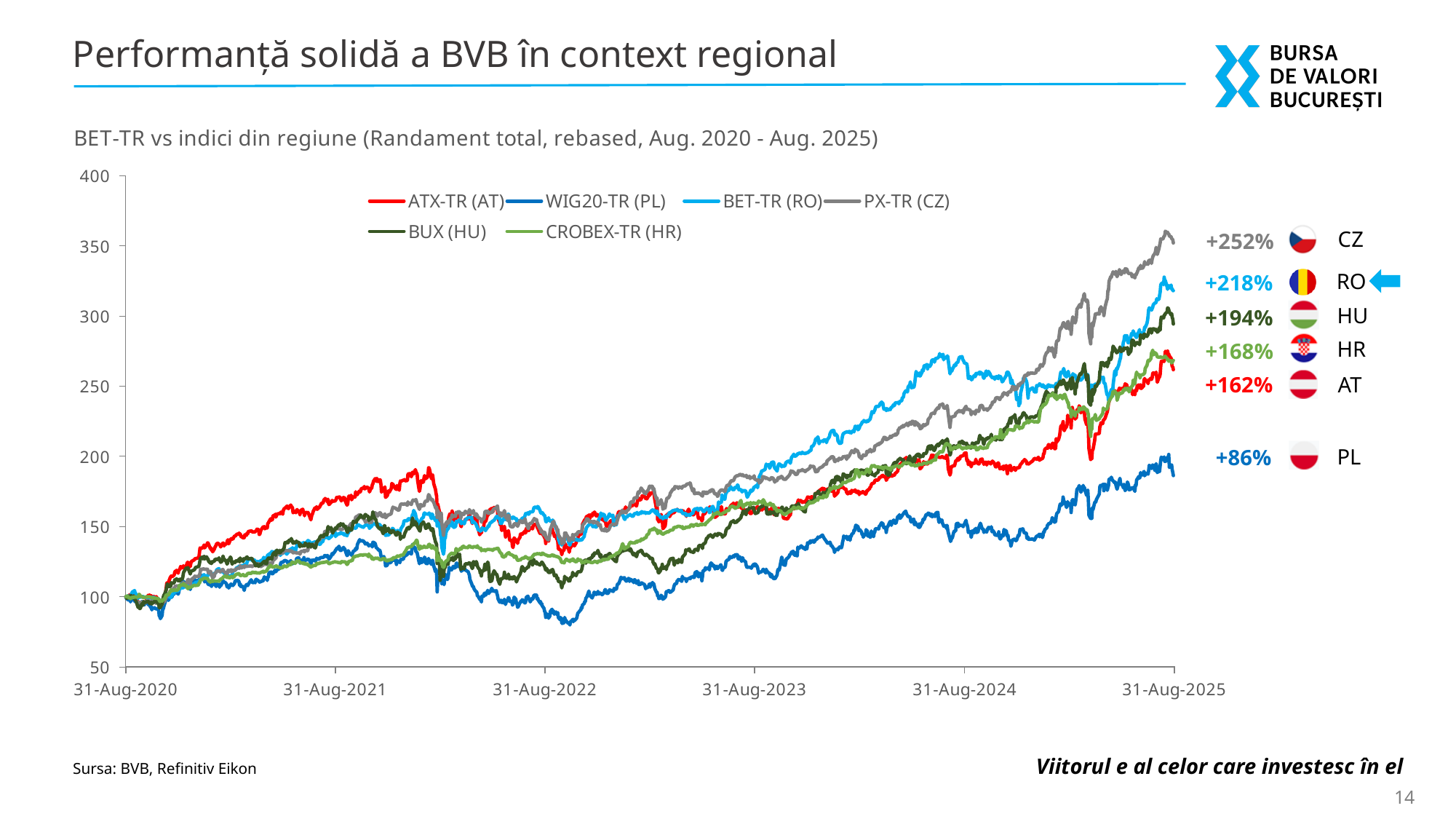
By how many percentage points does the CZ return exceed the RO return? 34 percentage points What total return is shown for PL (WIG20-TR) over the period? +86% What total return is shown for CZ (PX-TR) over the period? +252% Is the value of WIG20-TR (PL) at the end of the period greater or less than 250? less How many series does the chart legend list? 6 Which index has the lowest total return shown on the chart? PL (WIG20-TR) Which has the larger total return, HU or HR? HU What kind of chart is shown on the slide? line chart What total return is shown for RO (BET-TR) over the period? +218% Which index has the highest total return shown on the chart? CZ (PX-TR) What is the title of the chart? BET-TR vs indici din regiune (Randament total, rebased, Aug. 2020 - Aug. 2025) Does the BET-TR (RO) line generally rise or fall from Aug. 2020 to Aug. 2025? rise